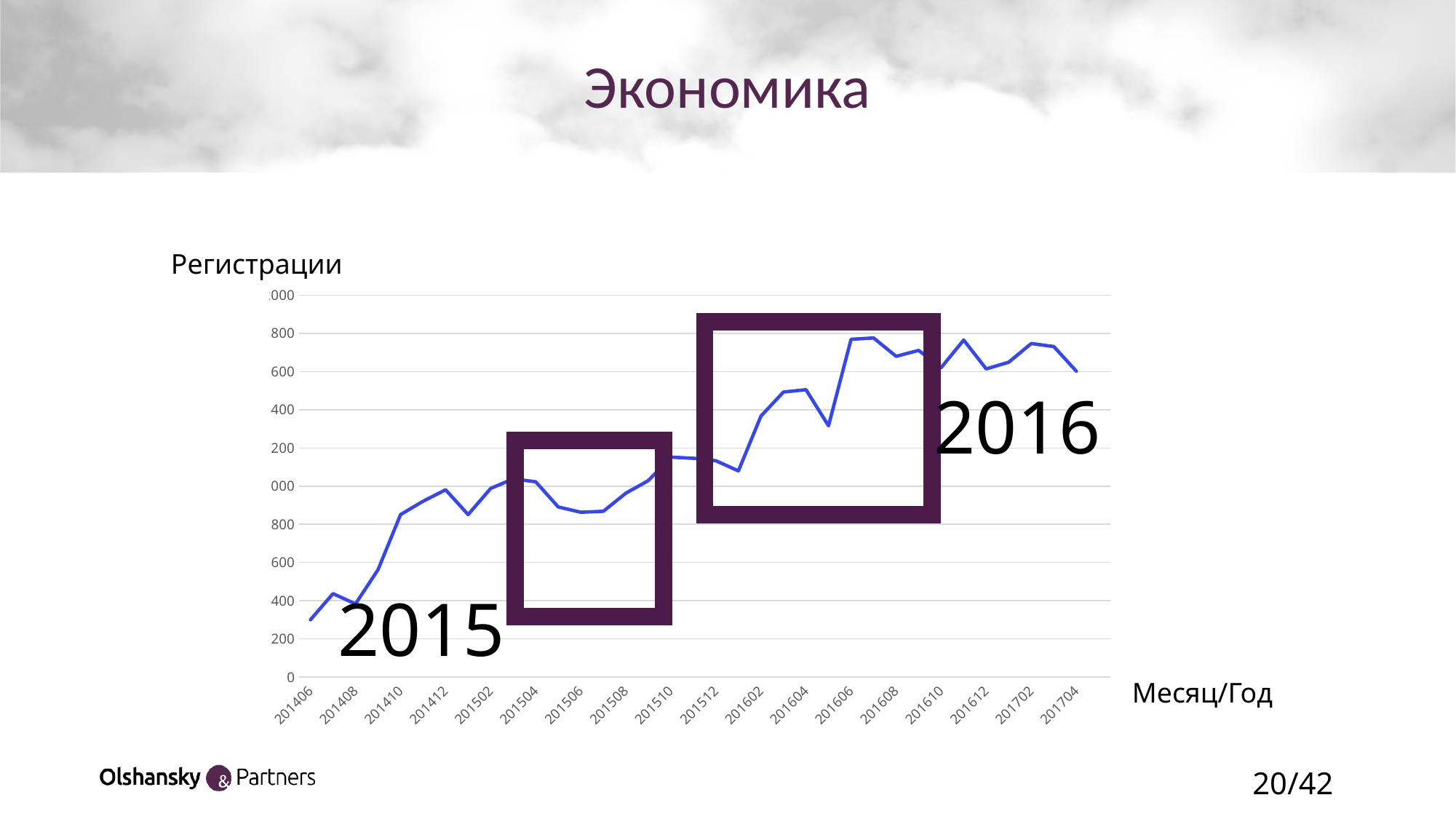
Do the values generally rise or fall from 201406 to 201704? rise Is the value for 201606 greater or less than 1600? greater Is the value for 201512 greater or less than 1000? greater Is the value for 201410 greater or less than 1000? less What is the label of the x axis? Месяц/Год Which month has the lowest value on the chart? 201406 What is the title of the chart? Регистрации Which is larger, the value for 201406 or the value for 201704? 201704 What kind of chart is shown on the slide? line chart